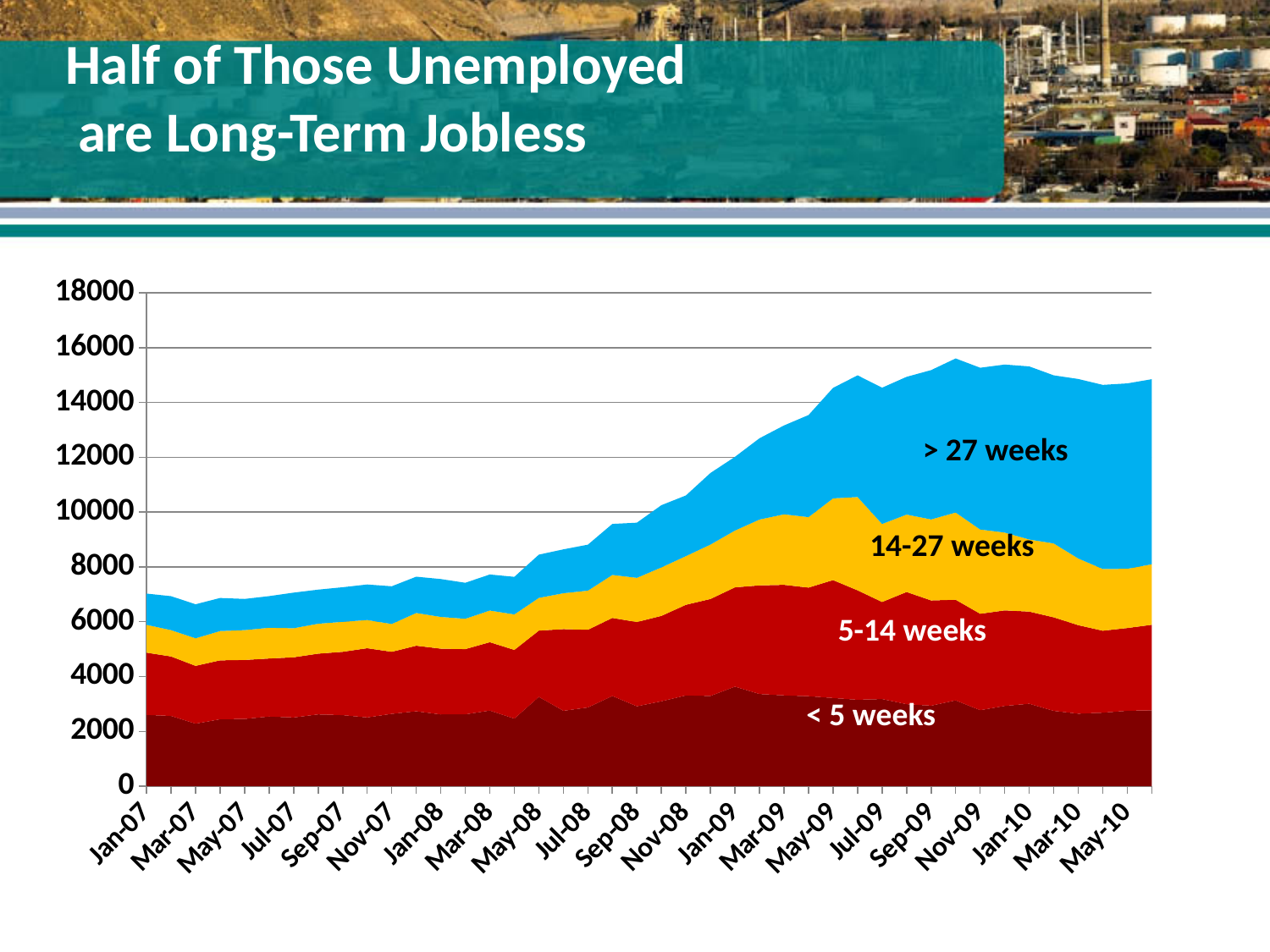
Which series has the largest value in May-10? > 27 weeks Does the total stacked value rise or fall from Jan-07 to Nov-09? Rise How many date labels are shown on the x axis? 21 What kind of chart is shown on the slide? Stacked area chart Is the total stacked value in May-10 greater or less than 16000? less Is the total stacked value larger in Jan-07 or in May-10? May-10 Is the total stacked value in Jan-07 greater or less than 8000? less What is the title of the slide? Half of Those Unemployed are Long-Term Jobless Is the total stacked value in Nov-09 greater or less than 14000? greater Which series is plotted as the topmost (blue) band? > 27 weeks How many series (duration bands) are shown in the chart? 4